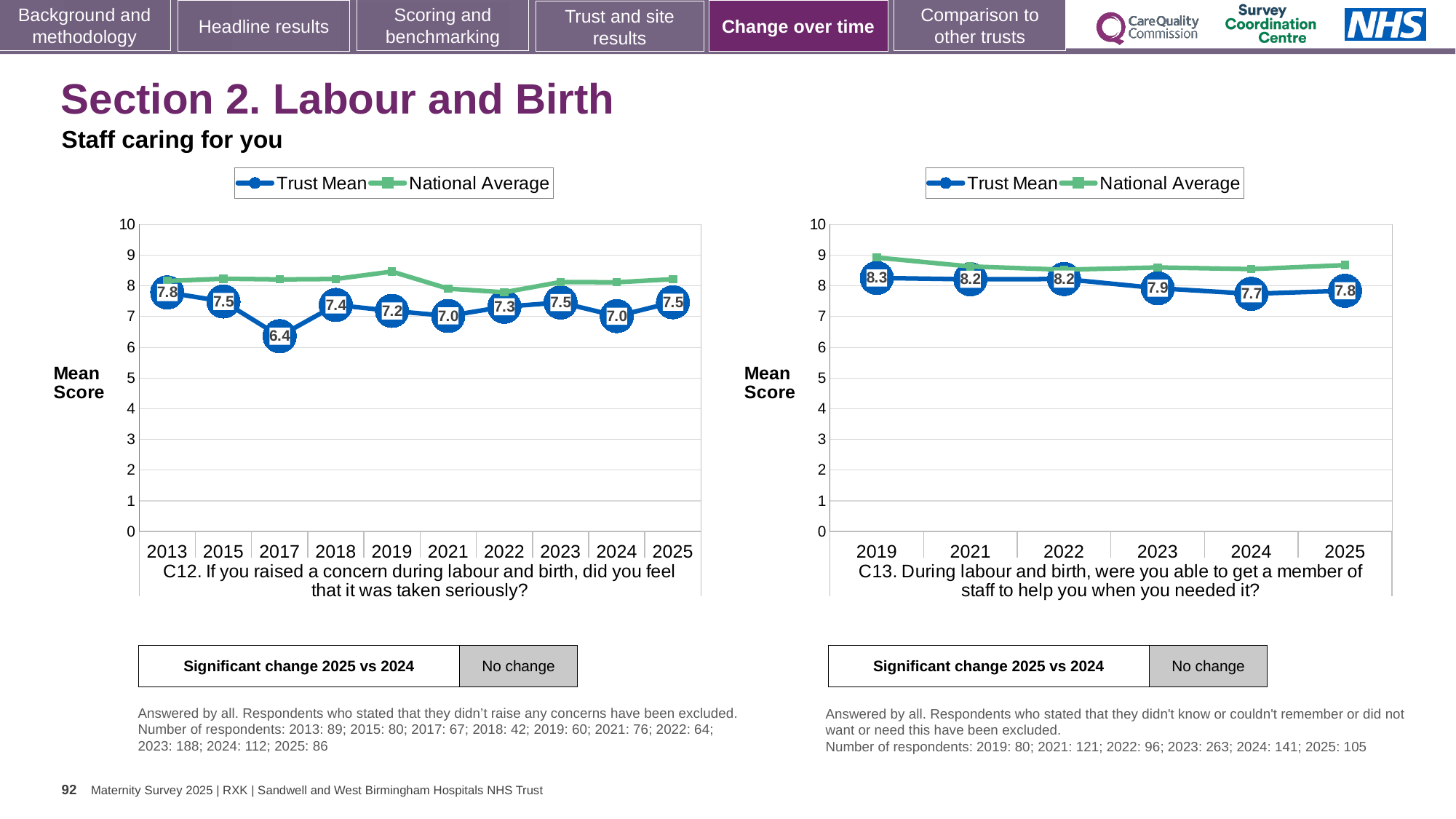
In the C13 chart on the right, what is the difference between the Trust Mean for 2019 and the Trust Mean for 2024? 0.6 In the C13 chart on the right, what is the Trust Mean for 2024? 7.7 In the C13 chart on the right, which year has the highest Trust Mean? 2019 How many years are shown on the x axis of the C13 chart on the right? 6 In the C13 chart on the right, does the Trust Mean generally rise or fall from 2019 to 2025? Fall In the C12 chart on the left, is the National Average for 2019 greater or less than 8? greater In the C12 chart on the left, which is larger: the Trust Mean for 2024 or the Trust Mean for 2025? 2025 In the C12 chart on the left, what is the difference between the Trust Mean for 2013 and the Trust Mean for 2017? 1.4 What kind of chart is the C13 chart on the right? Line chart How many series does the legend of the C12 chart on the left list? 2 In the C12 chart on the left, what is the Trust Mean for 2017? 6.4 In the C12 chart on the left, which year has the lowest Trust Mean? 2017